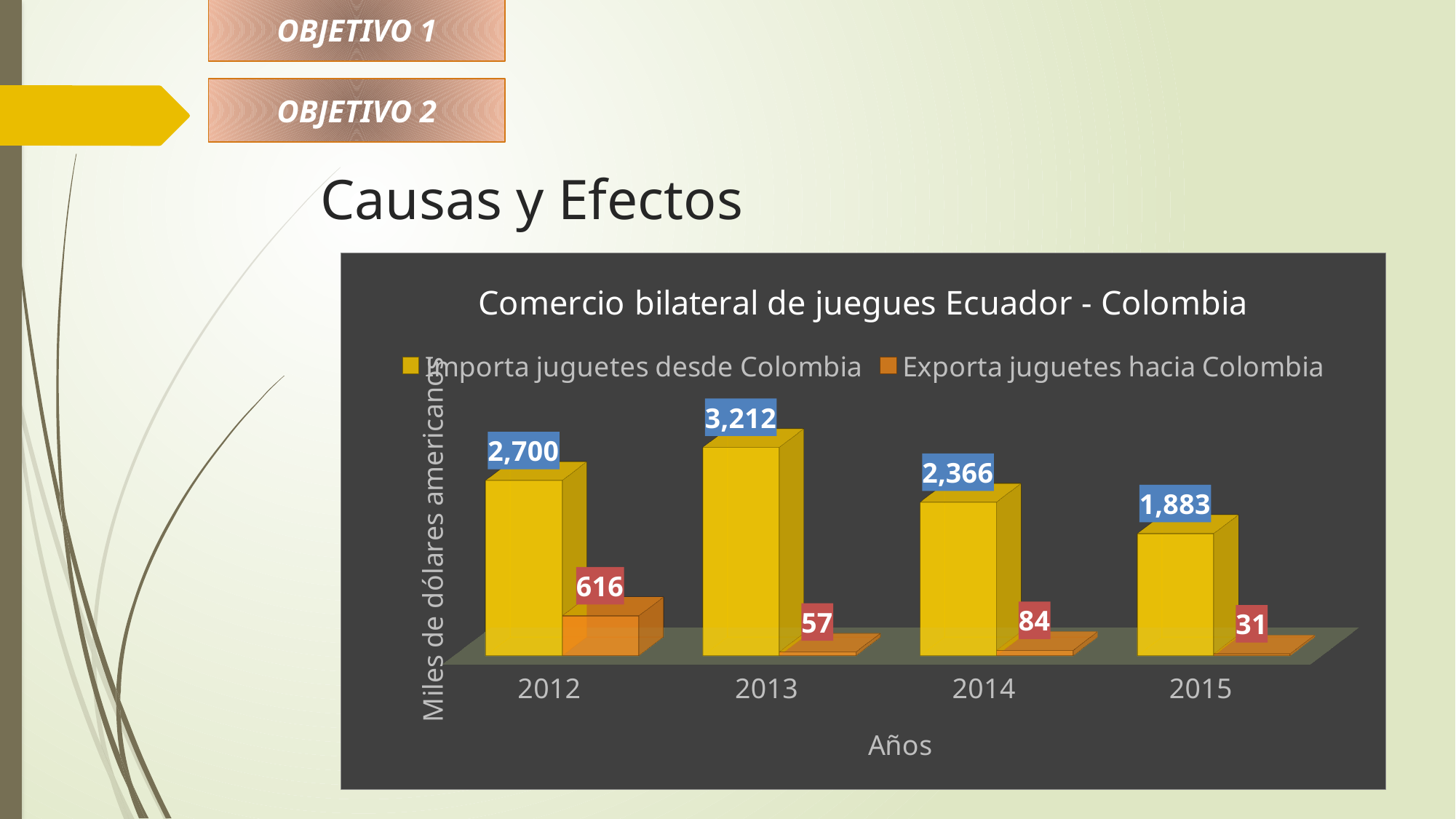
What is the difference between 'Importa juguetes desde Colombia' in 2013 and in 2012? 512 What kind of chart is shown on the slide? Bar chart What is the value of 'Importa juguetes desde Colombia' in 2015? 1,883 What is the value of 'Exporta juguetes hacia Colombia' in 2014? 84 In which year is 'Importa juguetes desde Colombia' highest? 2013 How many series does the legend list? 2 What is the title of the chart? Comercio bilateral de juegues Ecuador - Colombia In which year is 'Exporta juguetes hacia Colombia' lowest? 2015 How many years are shown on the x axis? 4 What is the value of 'Importa juguetes desde Colombia' in 2013? 3,212 What is the value of 'Exporta juguetes hacia Colombia' in 2012? 616 Which is larger: 'Exporta juguetes hacia Colombia' in 2013 or in 2014? 2014